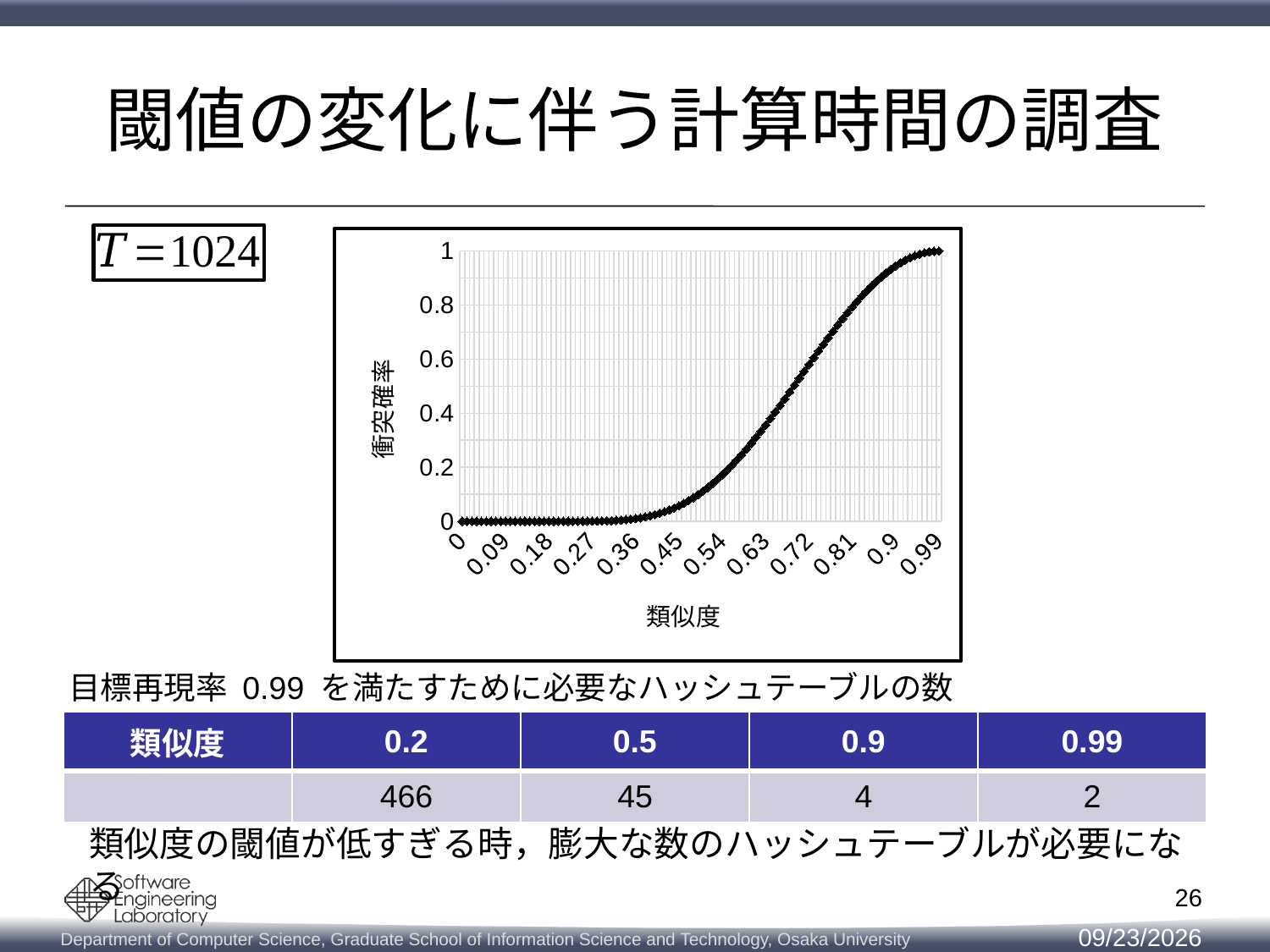
Is the value of 衝突確率 at 類似度 0.45 greater or less than 0.2? less Is the value of 衝突確率 at 類似度 0.72 greater or less than 0.4? greater At which labelled 類似度 value on the x axis is 衝突確率 highest? 0.99 Which has the larger 衝突確率, 類似度 0.9 or 類似度 0.45? 0.9 What kind of chart is shown on the slide? line chart Is the value of 衝突確率 at 類似度 0.27 greater or less than 0.2? less Do the values in the chart rise or fall as 類似度 increases along the x axis? rise What is the title of the x axis of the chart? 類似度 How many tick labels are shown on the x axis of the chart? 12 What is the value of 衝突確率 at 類似度 0? 0 What is the title of the y axis of the chart? 衝突確率